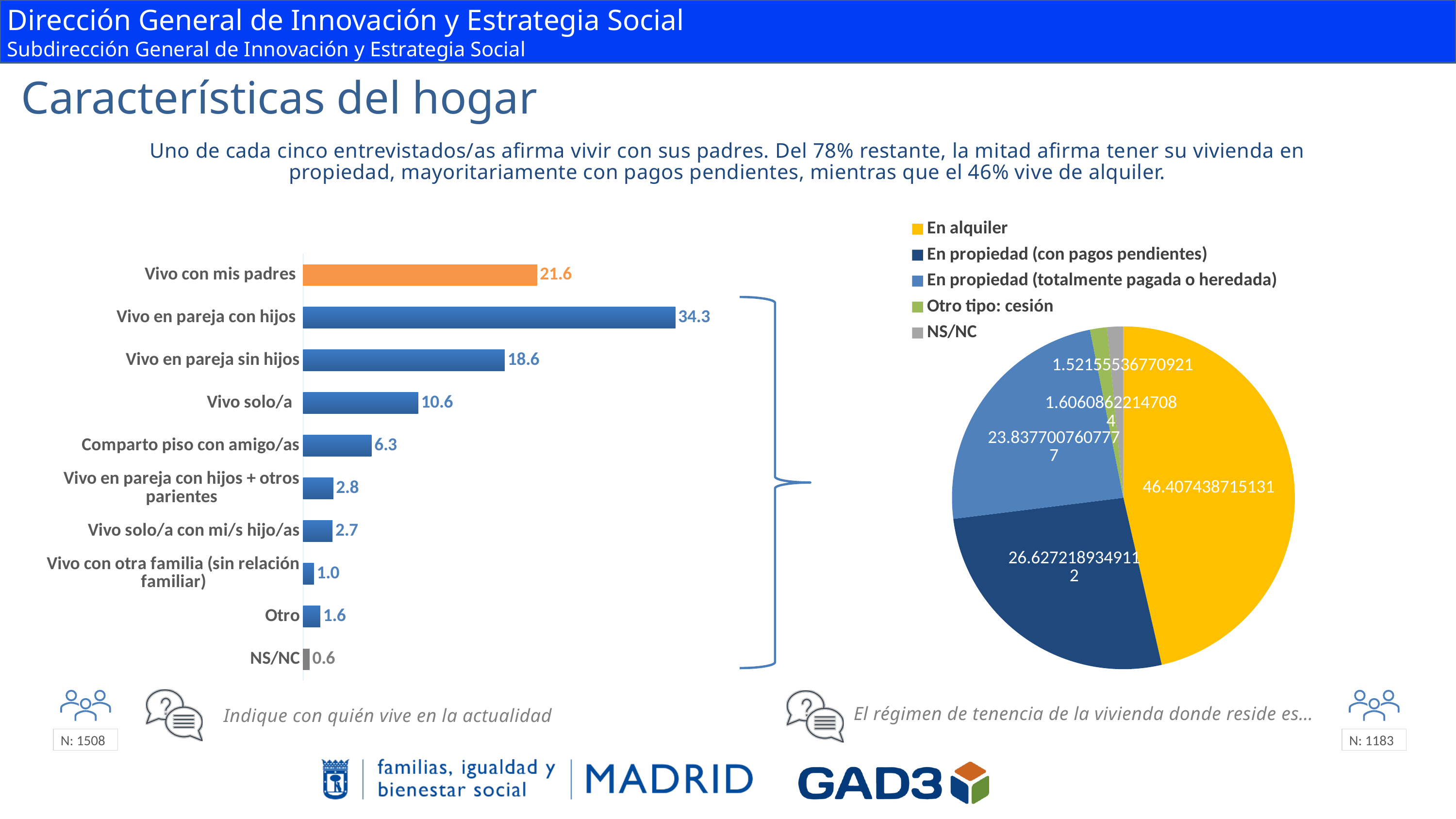
In the bar chart on the left, which is larger: "Otro" or "Vivo con otra familia (sin relación familiar)"? Otro What kind of chart is the chart on the left of the slide? Bar chart In the pie chart on the right, which category has the largest slice? En alquiler How many categories are shown in the bar chart on the left? 10 How many entries does the legend of the pie chart on the right list? 5 In the bar chart on the left, which category has the highest value? Vivo en pareja con hijos In the bar chart on the left, what is the difference between "Vivo en pareja con hijos" and "Vivo con mis padres"? 12.7 In the bar chart on the left, which category is drawn in orange? Vivo con mis padres In the bar chart on the left, which category has the lowest value? NS/NC In the pie chart on the right, what is the value for "En alquiler"? 46.407438715131 In the bar chart on the left, what is the value for "Vivo solo/a"? 10.6 In the bar chart on the left, what is the value for "Vivo con mis padres"? 21.6